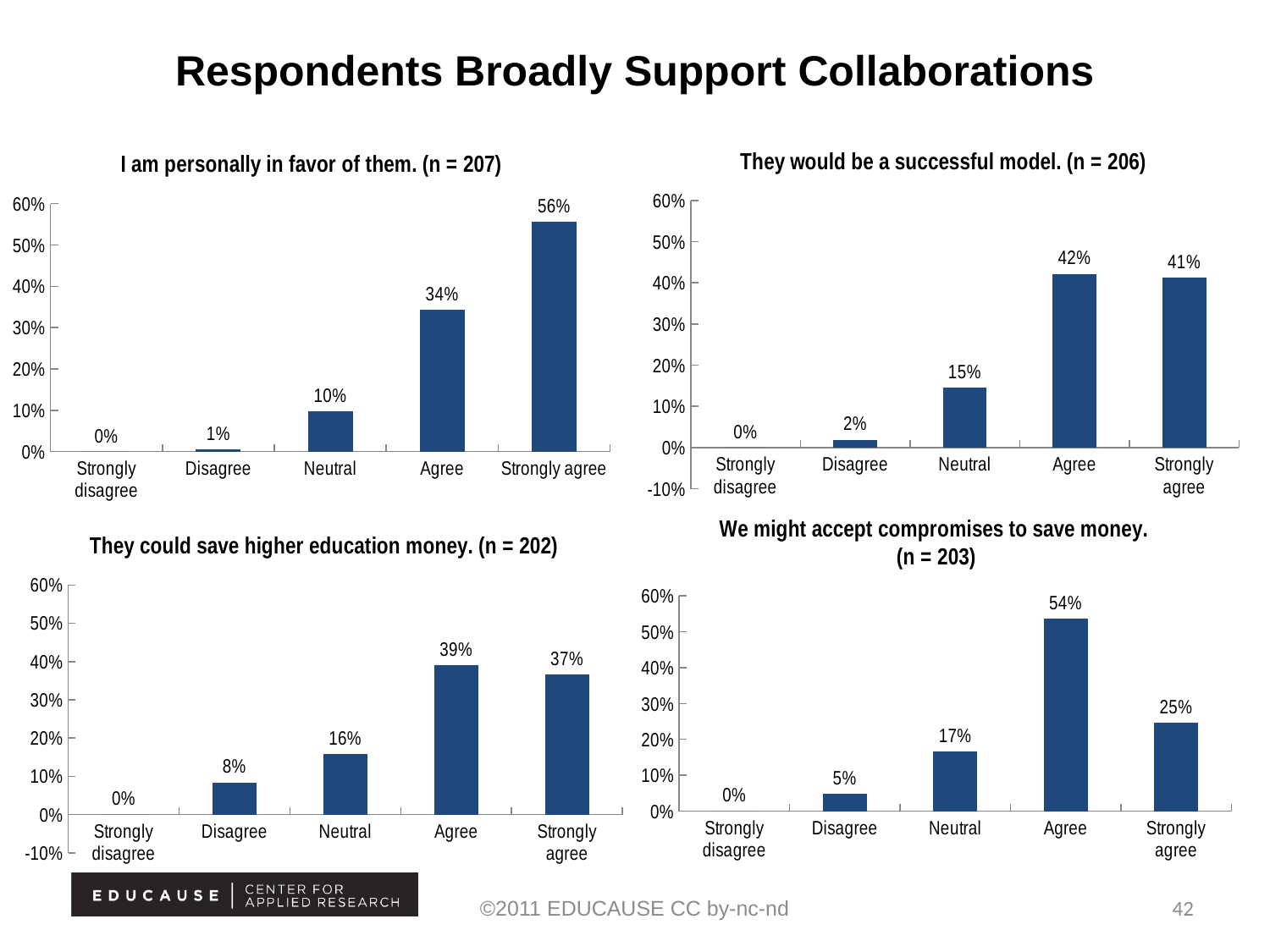
What kind of chart is the chart titled "They could save higher education money. (n = 202)"? Bar chart How many charts are shown on the slide? 4 How many categories are shown in the chart titled "They would be a successful model. (n = 206)"? 5 In the chart titled "They could save higher education money. (n = 202)", which is larger, the value for Agree or the value for Neutral? Agree In the chart titled "I am personally in favor of them. (n = 207)", what is the value for Strongly agree? 56% In the chart titled "They could save higher education money. (n = 202)", what is the value for Disagree? 8% In the chart titled "I am personally in favor of them. (n = 207)", do the values rise or fall from Strongly disagree to Strongly agree? Rise In the chart titled "I am personally in favor of them. (n = 207)", which category has the lowest value? Strongly disagree In the chart titled "We might accept compromises to save money. (n = 203)", which category has the highest value? Agree In the chart titled "They would be a successful model. (n = 206)", what is the difference between the values for Agree and Disagree? 40% In the chart titled "We might accept compromises to save money. (n = 203)", what is the difference between the values for Agree and Strongly agree? 29% In the chart titled "They would be a successful model. (n = 206)", what is the value for Neutral? 15%